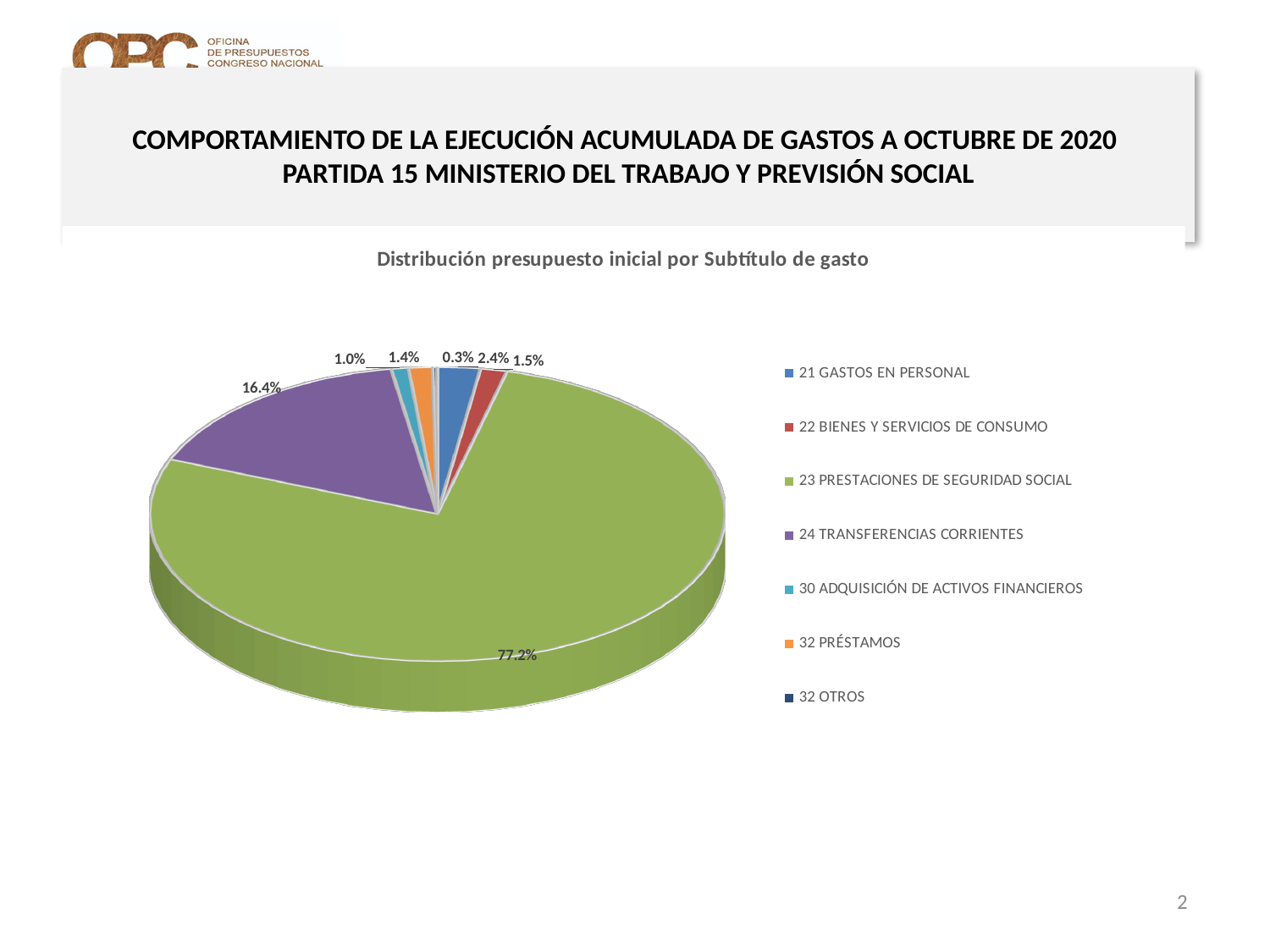
What is the difference in percentage points between 23 PRESTACIONES DE SEGURIDAD SOCIAL and 24 TRANSFERENCIAS CORRIENTES? 60.8 percentage points What share of the pie does 23 PRESTACIONES DE SEGURIDAD SOCIAL represent? 77.2% What is the title of the pie chart? Distribución presupuesto inicial por Subtítulo de gasto How many categories does the legend of the pie chart list? 7 What kind of chart is shown on the slide? Pie chart What is the value shown for 21 GASTOS EN PERSONAL? 2.4% Which is larger, the slice for 21 GASTOS EN PERSONAL or the slice for 22 BIENES Y SERVICIOS DE CONSUMO? 21 GASTOS EN PERSONAL Which category has the largest slice of the pie? 23 PRESTACIONES DE SEGURIDAD SOCIAL What is the value shown for 22 BIENES Y SERVICIOS DE CONSUMO? 1.5% What is the combined share of 23 PRESTACIONES DE SEGURIDAD SOCIAL and 24 TRANSFERENCIAS CORRIENTES? 93.6% What share of the pie does 24 TRANSFERENCIAS CORRIENTES represent? 16.4% Which category has the smallest slice of the pie? 32 OTROS